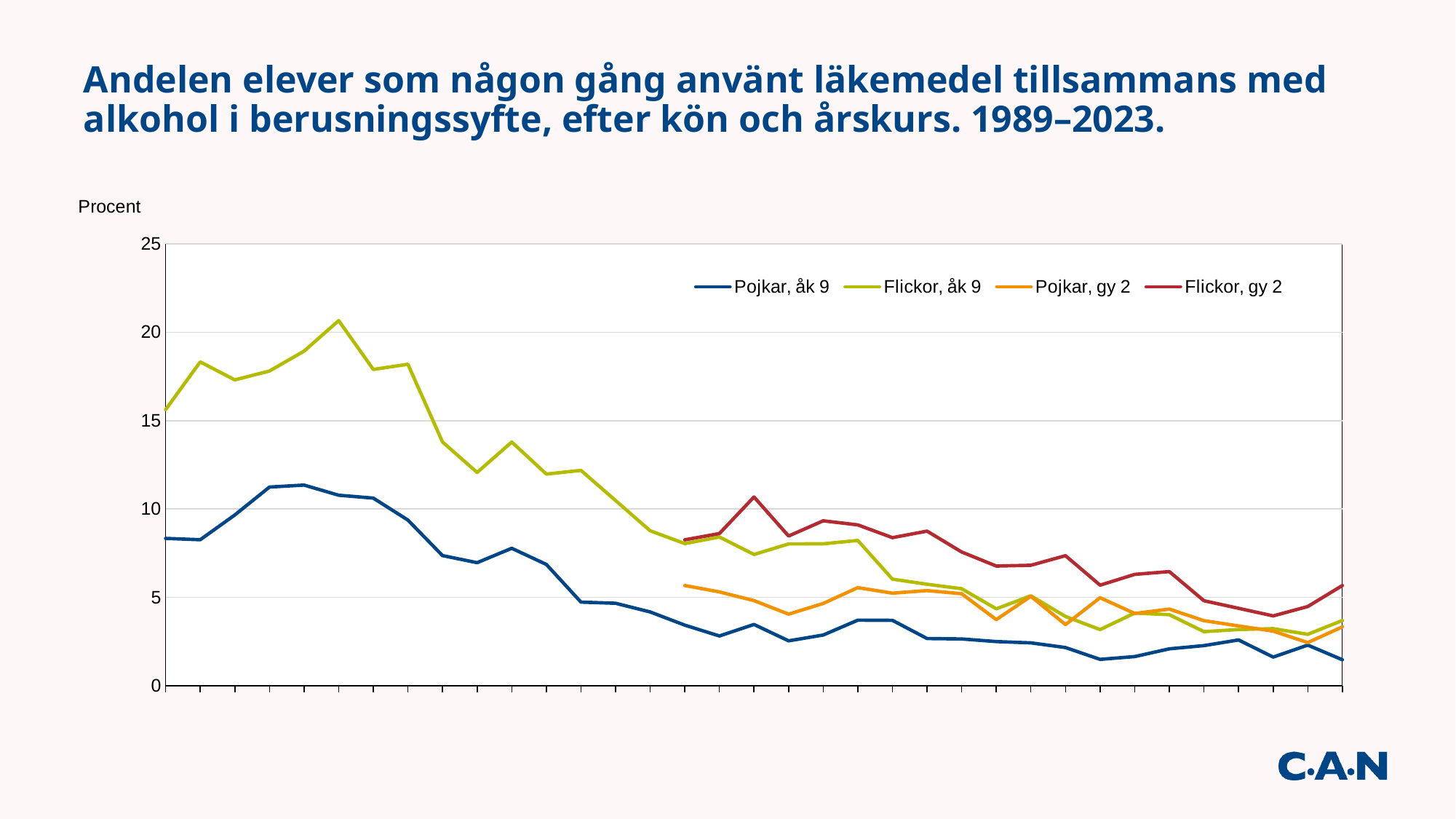
Which series reaches the highest value anywhere on the chart? Flickor, åk 9 What is the label on the vertical axis? Procent What kind of chart is shown on the slide? Line chart Is the highest value of the Flickor, åk 9 series greater or less than 20? greater At the start of the series, which is higher: Flickor, åk 9 or Pojkar, åk 9? Flickor, åk 9 How many series does the legend list? 4 Which series has the lowest value at the right-hand end of the chart? Pojkar, åk 9 Is the highest value of the Pojkar, åk 9 series greater or less than 15? less Which series are listed in the legend? Pojkar, åk 9; Flickor, åk 9; Pojkar, gy 2; Flickor, gy 2 Over the whole period, does the Flickor, åk 9 series rise or fall? Fall Over the whole period, does the Pojkar, åk 9 series rise or fall? Fall Is the highest value of the Flickor, gy 2 series greater or less than 10? greater